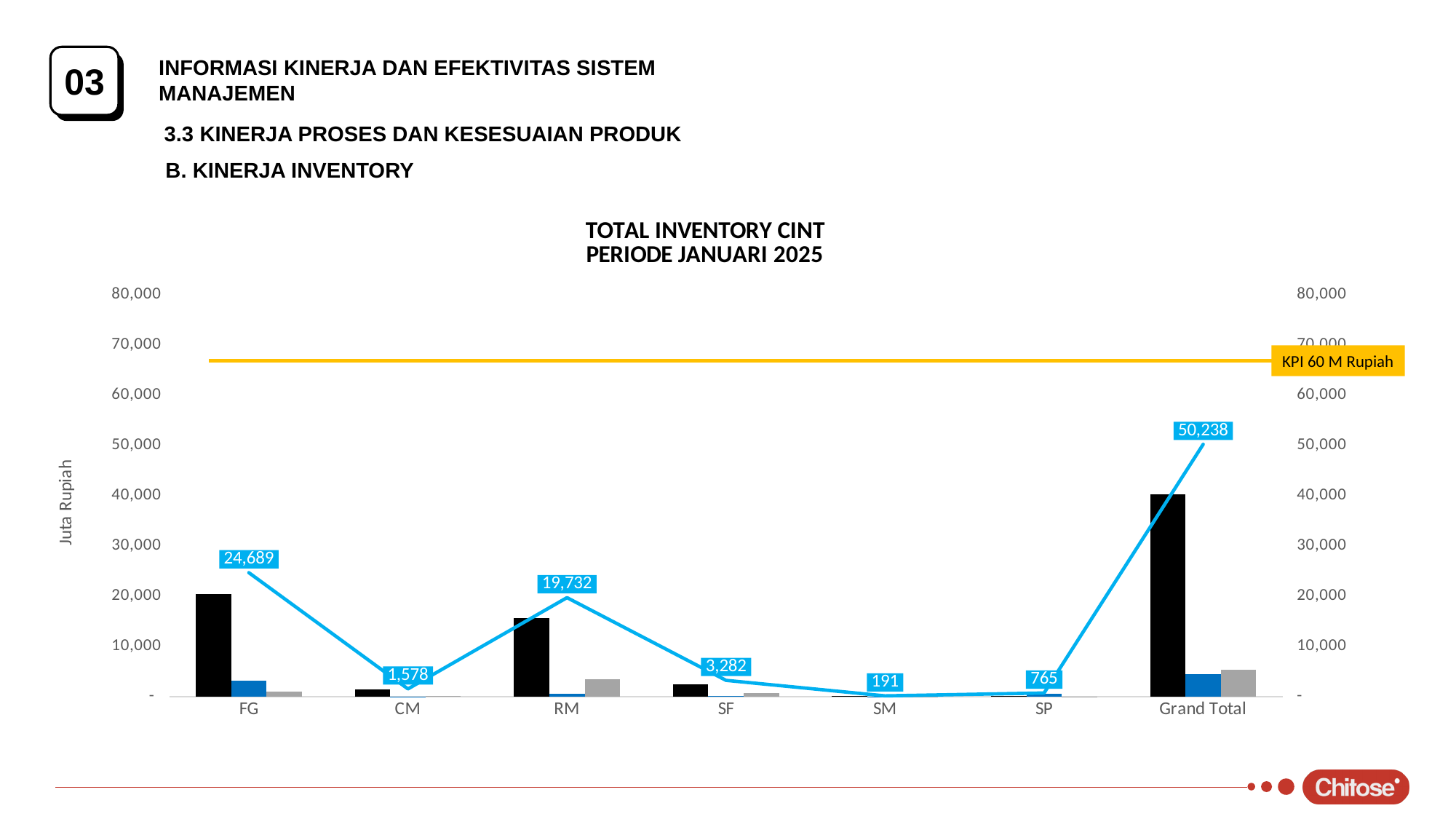
What is the line value labelled for RM? 19,732 What is the difference between the labelled line values for FG and RM? 4,957 What is the line value labelled for SM? 191 What is the label on the vertical axis? Juta Rupiah Which has the larger labelled line value, SF or SP? SF Which category has the lowest labelled line value? SM What is the line value labelled for FG? 24,689 What is the line value labelled for Grand Total? 50,238 Is the black bar for RM greater or less than 10,000? greater How many categories are shown on the x axis? 7 What kind of chart is this? Combined bar and line chart Excluding Grand Total, which category has the highest labelled line value? FG